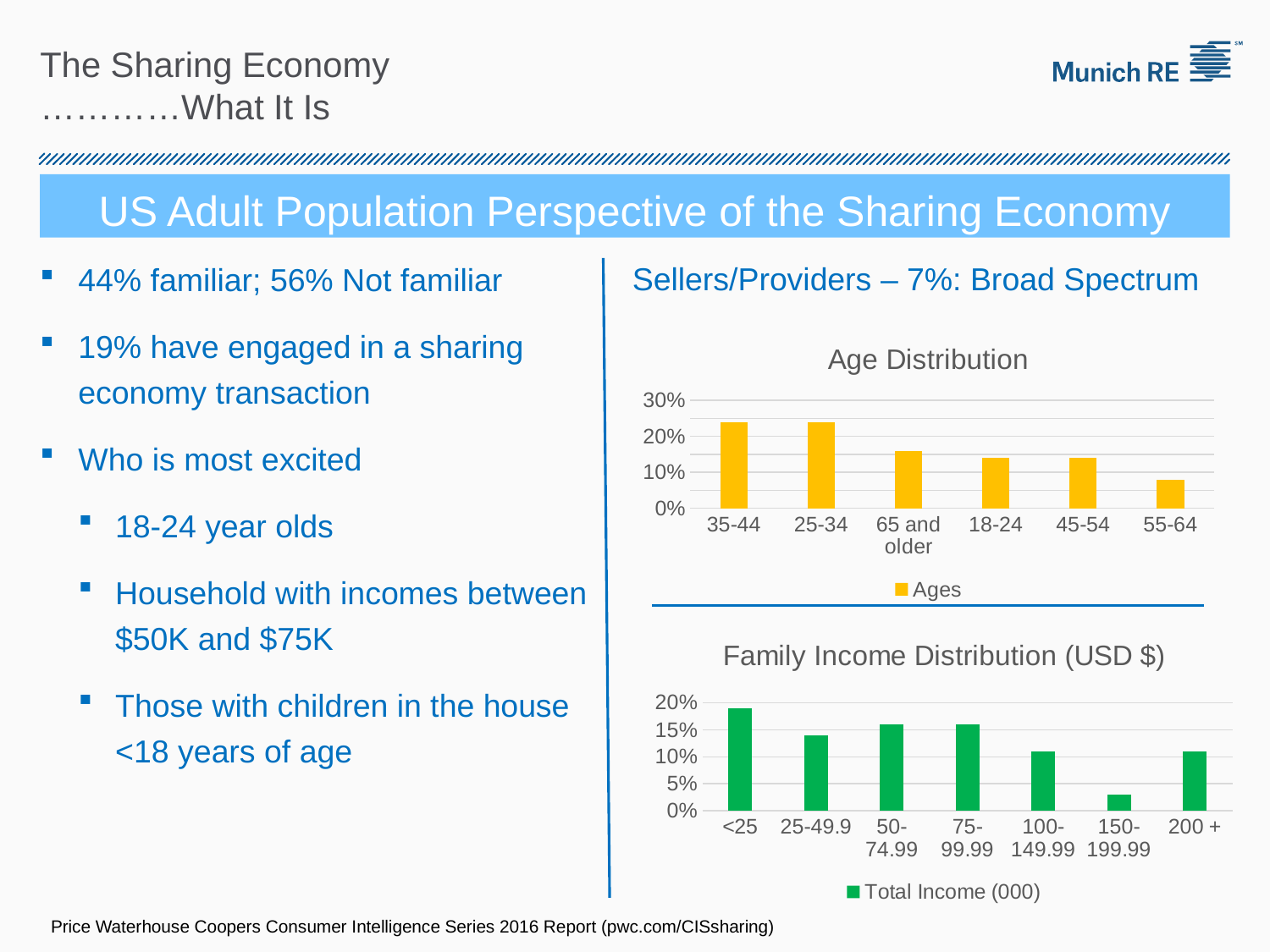
In the Family Income Distribution (USD $) chart, is the value for 150-199.99 greater or less than 5%? less What is the legend entry of the Age Distribution chart? Ages In the Age Distribution chart, which age group has the lowest value? 55-64 How many age categories are shown in the Age Distribution chart? 6 How many income categories are shown in the Family Income Distribution (USD $) chart? 7 In the Family Income Distribution (USD $) chart, which income category has the lowest value? 150-199.99 In the Age Distribution chart, is the value for 35-44 greater or less than 20%? greater In the Family Income Distribution (USD $) chart, which income category has the highest value? <25 In the Age Distribution chart, which is larger, the value for 65 and older or the value for 55-64? 65 and older What kind of chart is the Age Distribution chart? bar chart In the Family Income Distribution (USD $) chart, which is larger, the value for <25 or the value for 25-49.9? <25 In the Age Distribution chart, is the value for 55-64 greater or less than 10%? less